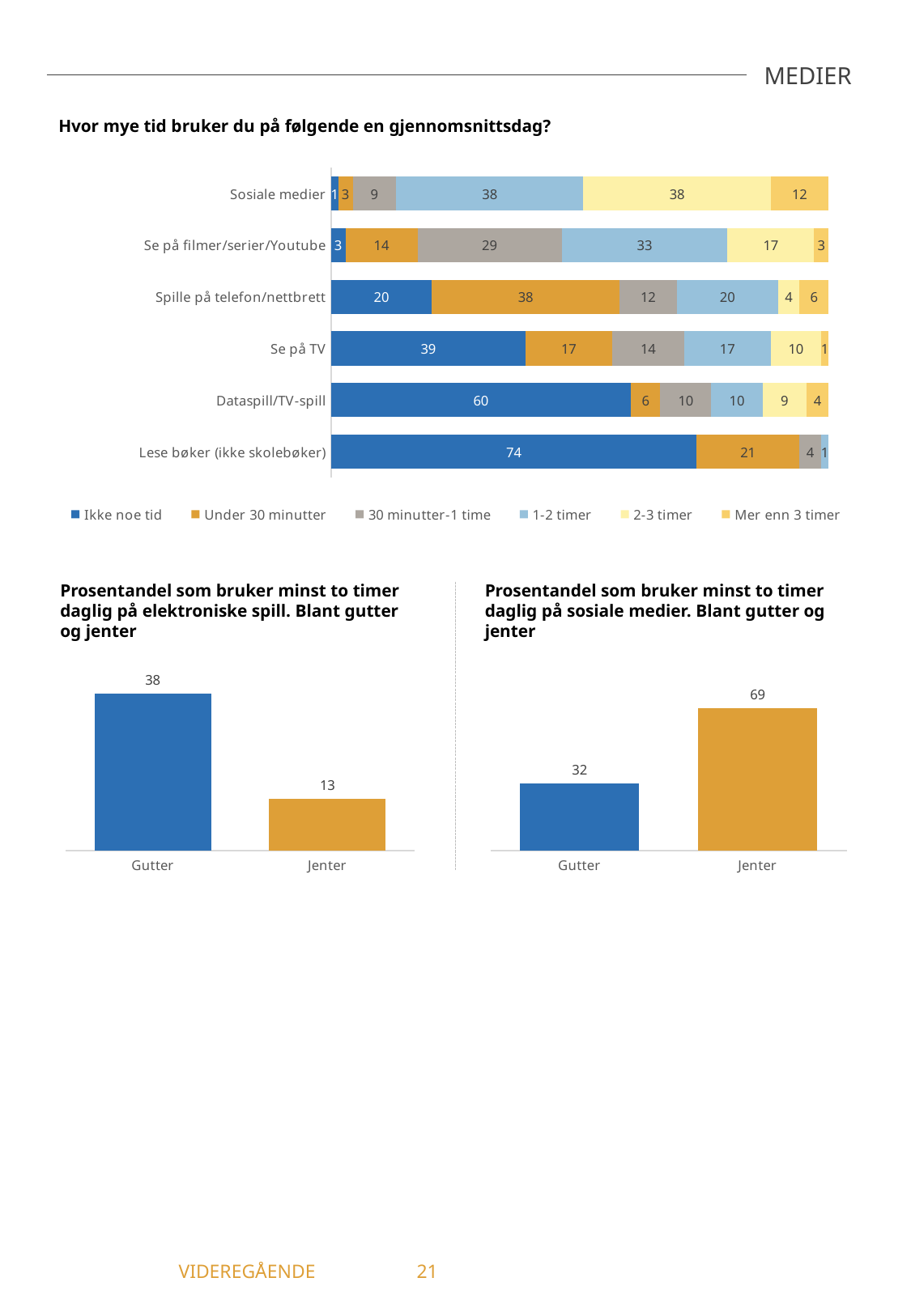
In the chart 'Hvor mye tid bruker du på følgende en gjennomsnittsdag?', what is the value of '1-2 timer' for 'Se på filmer/serier/Youtube'? 33 In the chart 'Prosentandel som bruker minst to timer daglig på sosiale medier. Blant gutter og jenter', what is the difference between 'Jenter' and 'Gutter'? 37 In the chart 'Prosentandel som bruker minst to timer daglig på elektroniske spill. Blant gutter og jenter', what is the value for 'Jenter'? 13 In the chart 'Hvor mye tid bruker du på følgende en gjennomsnittsdag?', which category has the lowest 'Ikke noe tid' value? Sosiale medier In the chart 'Hvor mye tid bruker du på følgende en gjennomsnittsdag?', which category has the highest 'Ikke noe tid' value? Lese bøker (ikke skolebøker) In the chart 'Prosentandel som bruker minst to timer daglig på sosiale medier. Blant gutter og jenter', which is larger, 'Gutter' or 'Jenter'? Jenter In the chart 'Prosentandel som bruker minst to timer daglig på elektroniske spill. Blant gutter og jenter', what is the difference between 'Gutter' and 'Jenter'? 25 What kind of chart is 'Hvor mye tid bruker du på følgende en gjennomsnittsdag?'? Stacked bar chart In the chart 'Hvor mye tid bruker du på følgende en gjennomsnittsdag?', what is the value of 'Ikke noe tid' for 'Lese bøker (ikke skolebøker)'? 74 In the chart 'Hvor mye tid bruker du på følgende en gjennomsnittsdag?', how many series does the legend list? 6 In the chart 'Hvor mye tid bruker du på følgende en gjennomsnittsdag?', what is the difference between the 'Under 30 minutter' values for 'Spille på telefon/nettbrett' and 'Se på TV'? 21 In the chart 'Hvor mye tid bruker du på følgende en gjennomsnittsdag?', how many categories are shown? 6